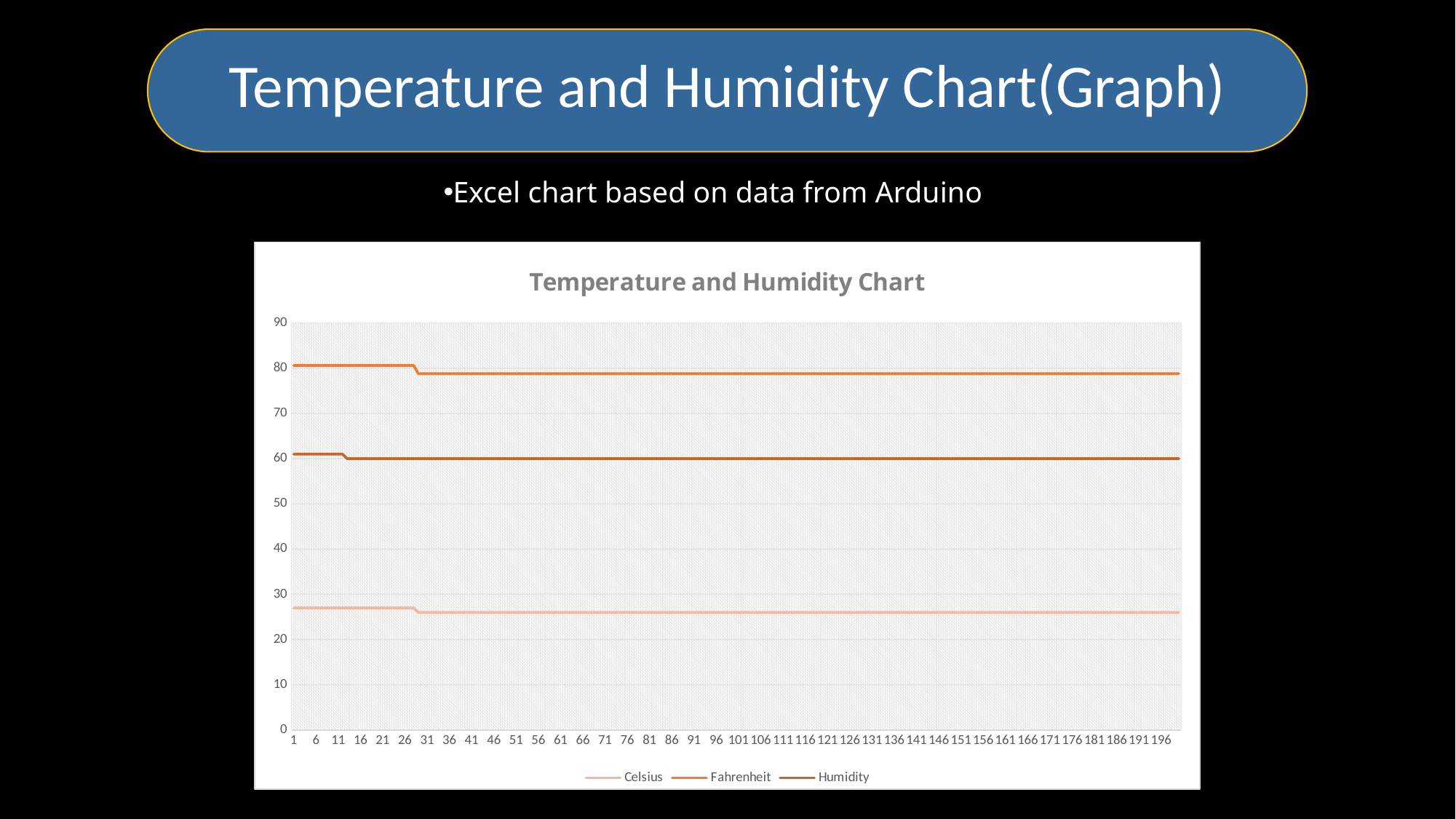
What kind of chart is shown on the slide? line chart Is the Humidity value at point 101 greater or less than 50? greater How many series does the chart's legend list? 3 Does the Fahrenheit line rise or fall from the left of the x axis to the right? fall Which series has the highest values on the chart? Fahrenheit What is the title of the chart? Temperature and Humidity Chart Is the Fahrenheit value at point 101 greater or less than 70? greater Which series are listed in the chart's legend? Celsius, Fahrenheit, Humidity Which series has the lowest values on the chart? Celsius Which series is higher on the chart, Humidity or Celsius? Humidity Is the Celsius value at point 101 greater or less than 30? less Which series is higher on the chart, Fahrenheit or Humidity? Fahrenheit